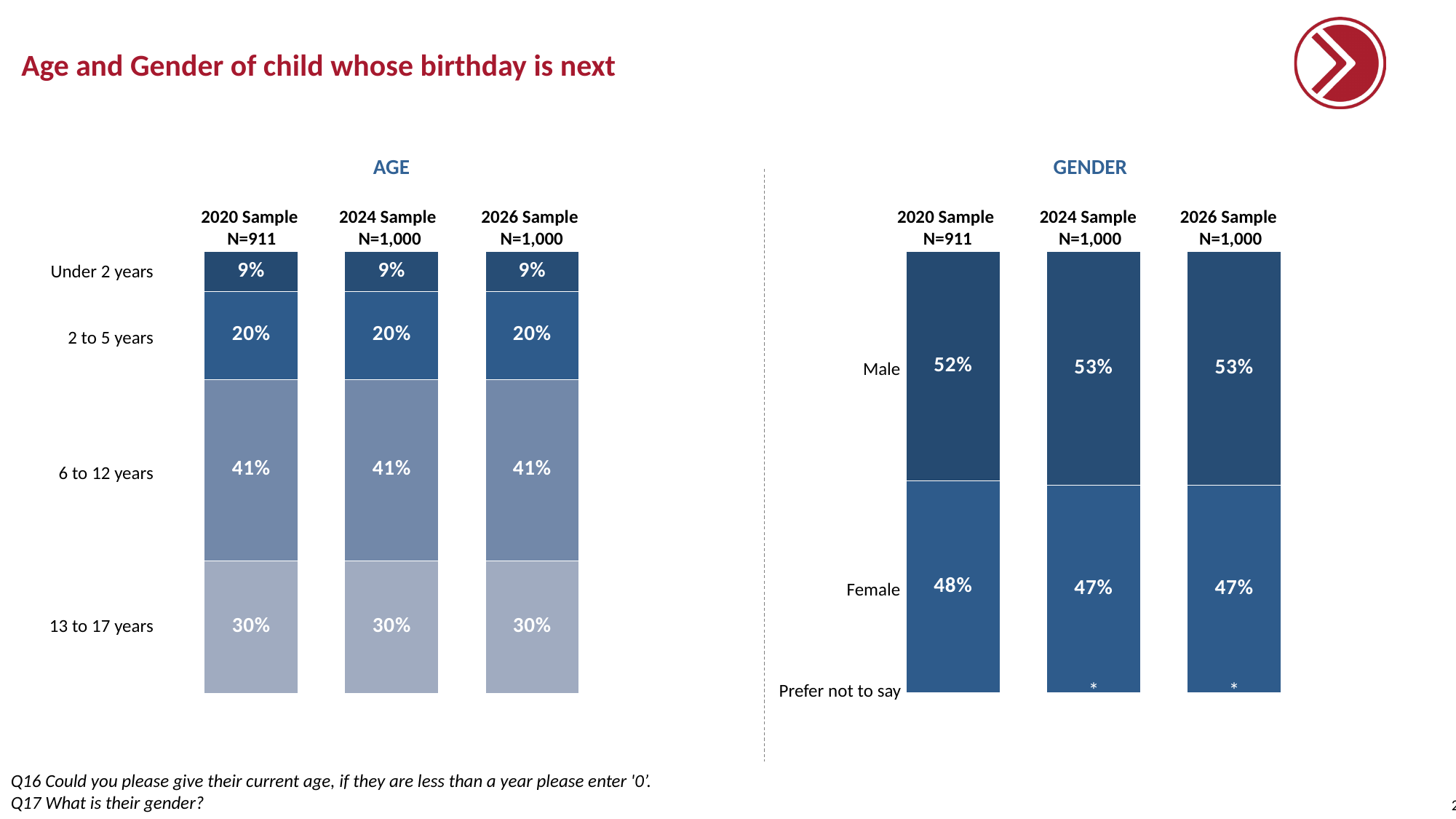
In the GENDER chart, what percentage of the 2026 Sample is Male? 53% In the AGE chart, what percentage of the 2020 Sample is Under 2 years? 9% In the GENDER chart, what percentage of the 2020 Sample is Female? 48% How many sample bars are shown in the AGE chart? 3 What is the sample size (N) for the 2020 Sample in the AGE chart? N=911 In the AGE chart, what is the difference between the 13 to 17 years and 2 to 5 years shares in the 2024 Sample? 10 percentage points In the AGE chart, which age group has the largest share in the 2026 Sample? 6 to 12 years In the AGE chart, what percentage of the 2024 Sample is 6 to 12 years? 41% What kind of chart is the GENDER chart? Stacked bar chart In the GENDER chart, is the Male share larger in the 2020 Sample or the 2024 Sample? 2024 Sample In the GENDER chart, what is the difference between the Male and Female shares in the 2024 Sample? 6 percentage points In the AGE chart, which age group has the smallest share in the 2020 Sample? Under 2 years